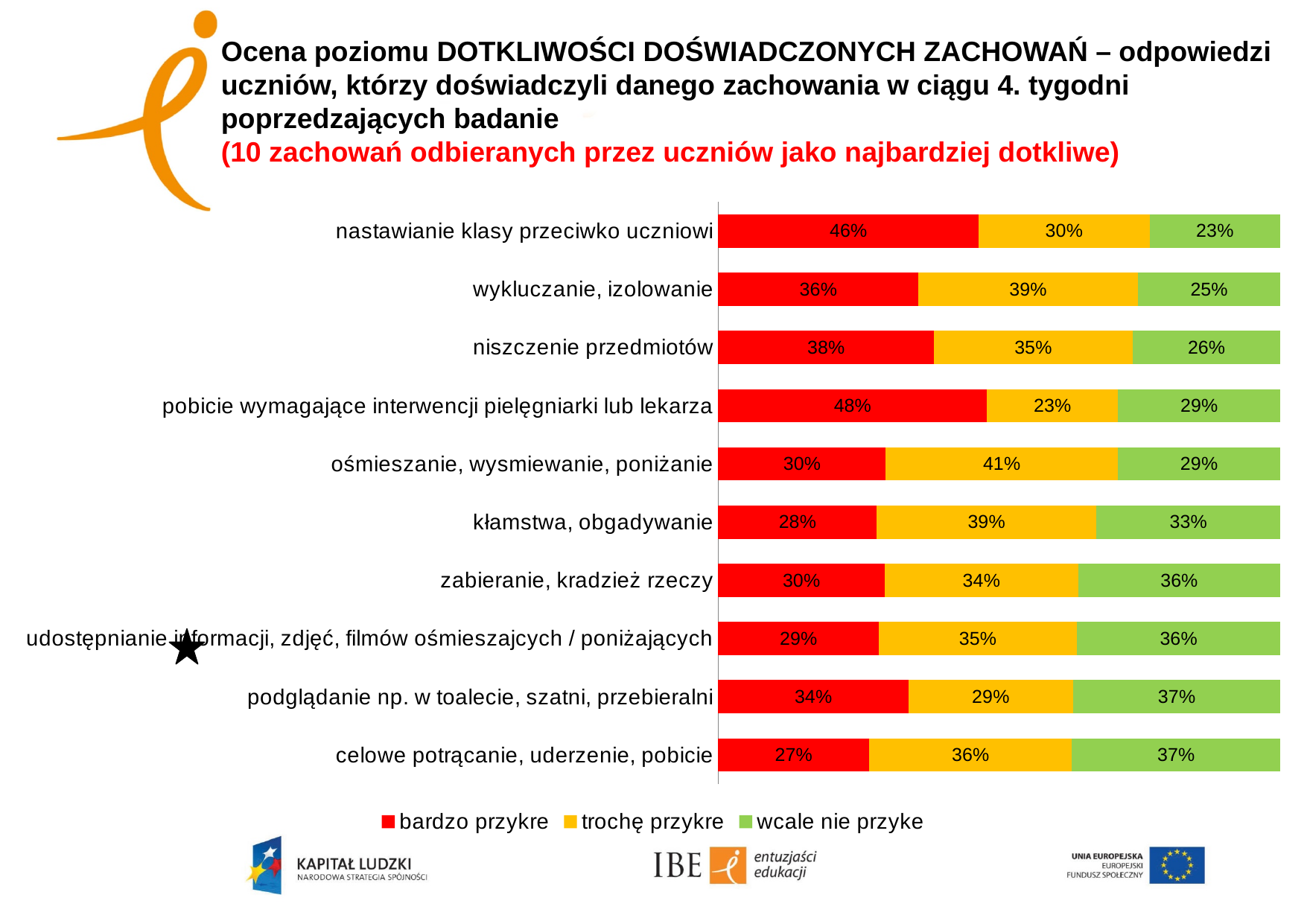
Which colour represents 'bardzo przykre' in the legend? red Which behaviour has the highest 'bardzo przykre' share? pobicie wymagające interwencji pielęgniarki lub lekarza How many behaviours (categories) are listed in the chart? 10 What kind of chart is shown on the slide? stacked bar chart What is the 'wcale nie przyke' value for 'nastawianie klasy przeciwko uczniowi'? 23% How many series does the legend list? 3 What is the 'bardzo przykre' value for 'pobicie wymagające interwencji pielęgniarki lub lekarza'? 48% What is the 'trochę przykre' value for 'ośmieszanie, wysmiewanie, poniżanie'? 41% Which is larger: the 'bardzo przykre' value for 'niszczenie przedmiotów' or for 'kłamstwa, obgadywanie'? niszczenie przedmiotów Which behaviour has the lowest 'wcale nie przyke' share? nastawianie klasy przeciwko uczniowi Which behaviour has the lowest 'bardzo przykre' share? celowe potrącanie, uderzenie, pobicie What is the difference between the 'bardzo przykre' values for 'pobicie wymagające interwencji pielęgniarki lub lekarza' and 'celowe potrącanie, uderzenie, pobicie'? 21 percentage points